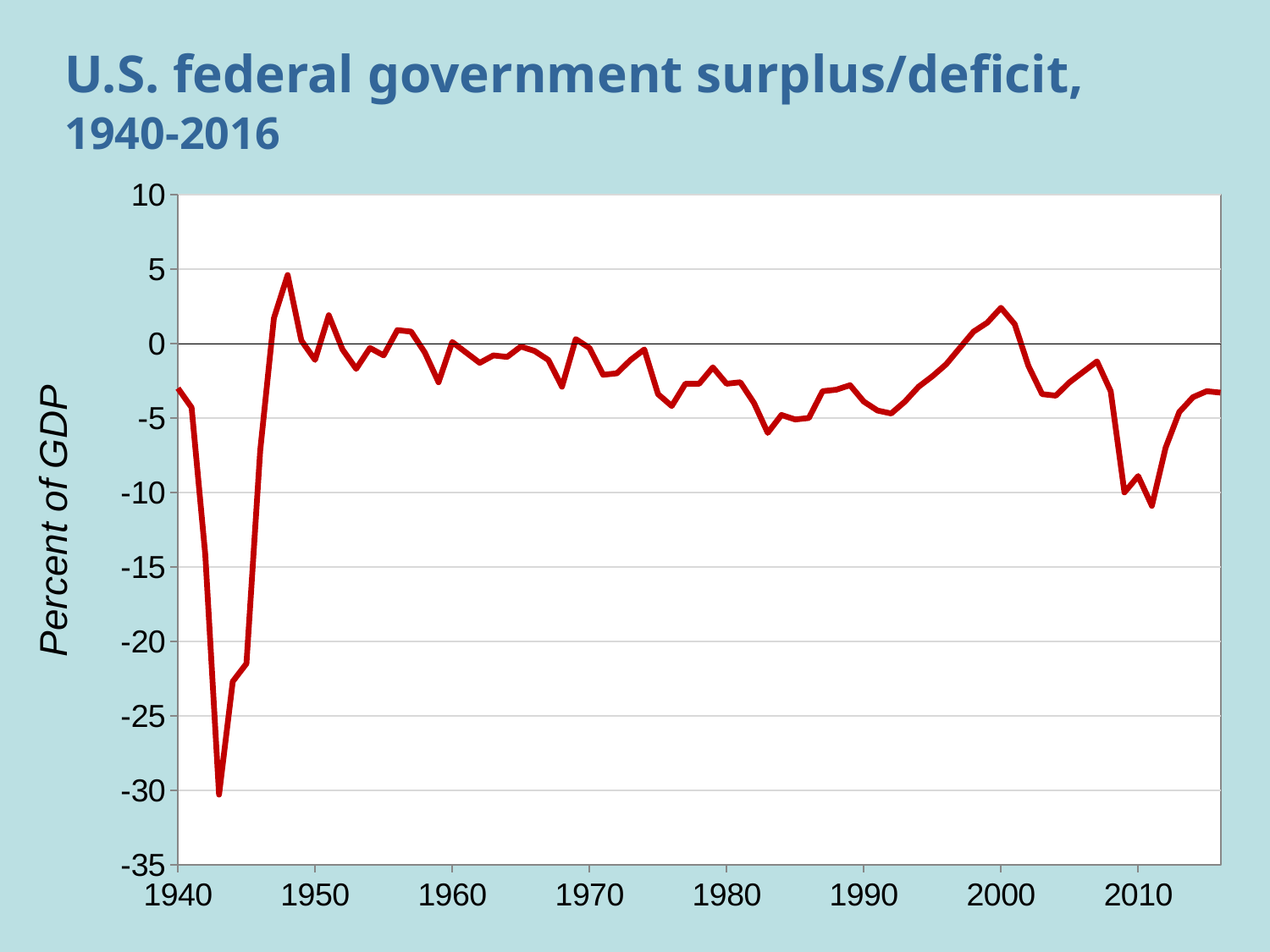
Is the lowest point of the line greater or less than -25? less In which decade does the line reach its lowest point? 1940s Is the value for 2000 greater or less than 0? greater Is the peak of the line in the late 1940s higher or lower than the peak around 2000? higher Between 2000 and 2010, does the line overall rise or fall? fall Is the value for 1940 greater or less than 0? less Is the value for 2000 higher or lower than the value for 2010? higher How many lines (series) are plotted on the chart? 1 What kind of chart is shown on the slide? line chart What is the label on the vertical axis? Percent of GDP What is the title of the chart? U.S. federal government surplus/deficit, 1940-2016